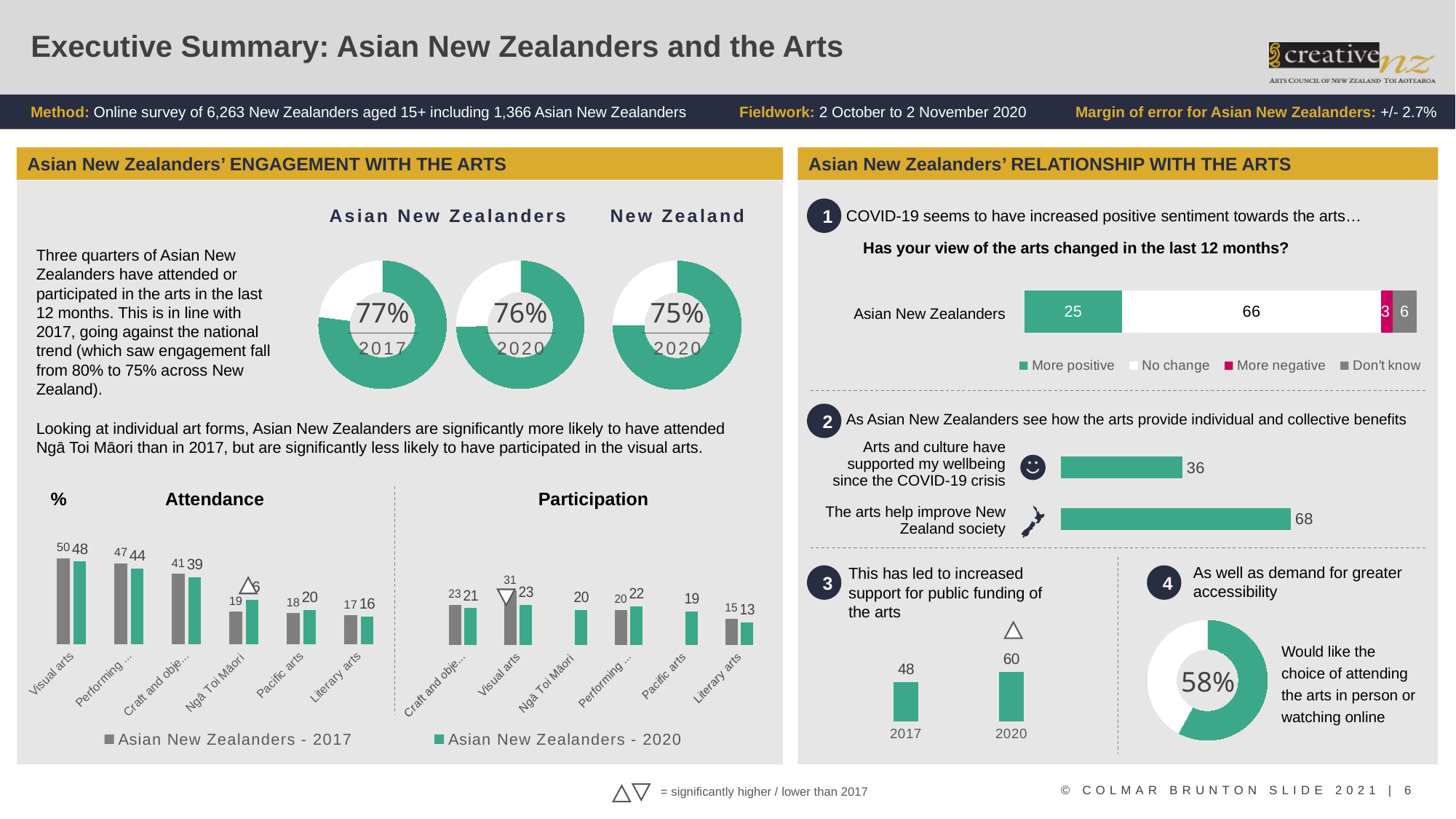
In the Attendance bar chart, what is the difference between the 2017 and 2020 values for Ngā Toi Māori? 7 In the chart under point 2, what is the value for 'The arts help improve New Zealand society'? 68 In the Attendance bar chart, which art form has the lowest value for Asian New Zealanders - 2020? Literary arts What percentage is shown in the New Zealand 2020 donut chart? 75% In the Participation bar chart, which is larger for Performing arts: the 2017 value or the 2020 value? 2020 In the Participation bar chart, how many art form categories are shown on the x axis? 6 In the chart under point 3 about support for public funding of the arts, what is the value for 2020? 60 In the 'Has your view of the arts changed in the last 12 months?' stacked bar chart, how many series does the legend list? 4 In the Attendance bar chart, what is the value for Visual arts for Asian New Zealanders - 2017? 50 In the Participation bar chart, what is the value for Visual arts for Asian New Zealanders - 2017? 31 In the 'Has your view of the arts changed in the last 12 months?' stacked bar chart, what is the total of the four segments for Asian New Zealanders? 100 In the 'Has your view of the arts changed in the last 12 months?' stacked bar chart, what percentage of Asian New Zealanders said 'No change'? 66